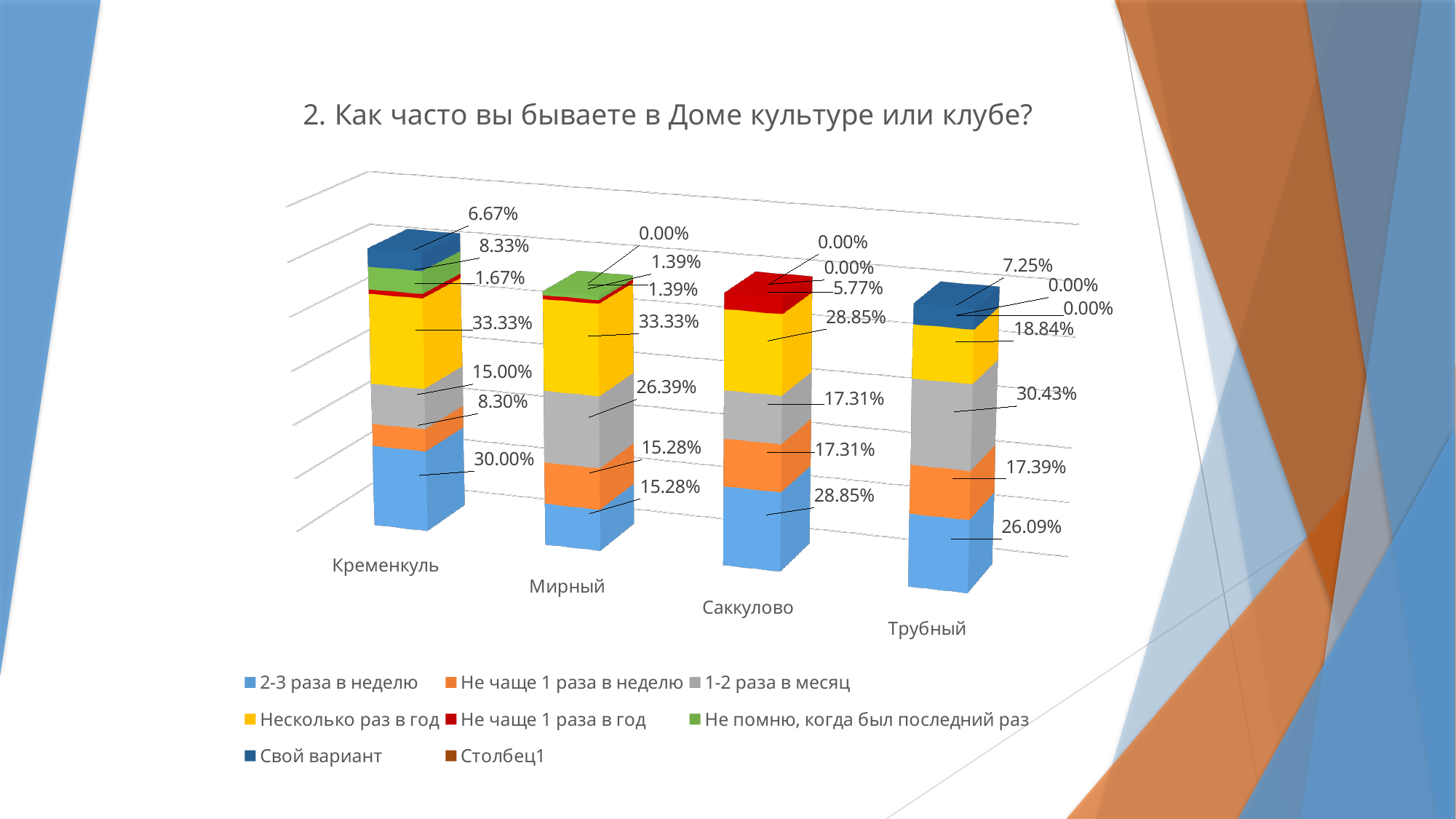
What is the title of the chart? 2. Как часто вы бываете в Доме культуре или клубе? Which is larger: the '1-2 раза в месяц' value for Саккулово or for Трубный? Трубный What is the difference between the 'Несколько раз в год' values for Кременкуль and Трубный? 14.49% What is the value for '2-3 раза в неделю' in Кременкуль? 30.00% How many settlements (categories) are shown on the x axis? 4 What is the value for 'Не чаще 1 раза в год' in Саккулово? 5.77% What kind of chart is shown on the slide? Stacked bar chart What is the value for '1-2 раза в месяц' in Мирный? 26.39% How many series does the legend list? 8 What is the value for '1-2 раза в месяц' in Трубный? 30.43% Which settlement has the lowest share for '2-3 раза в неделю'? Мирный Which settlement has the highest share for '2-3 раза в неделю'? Кременкуль